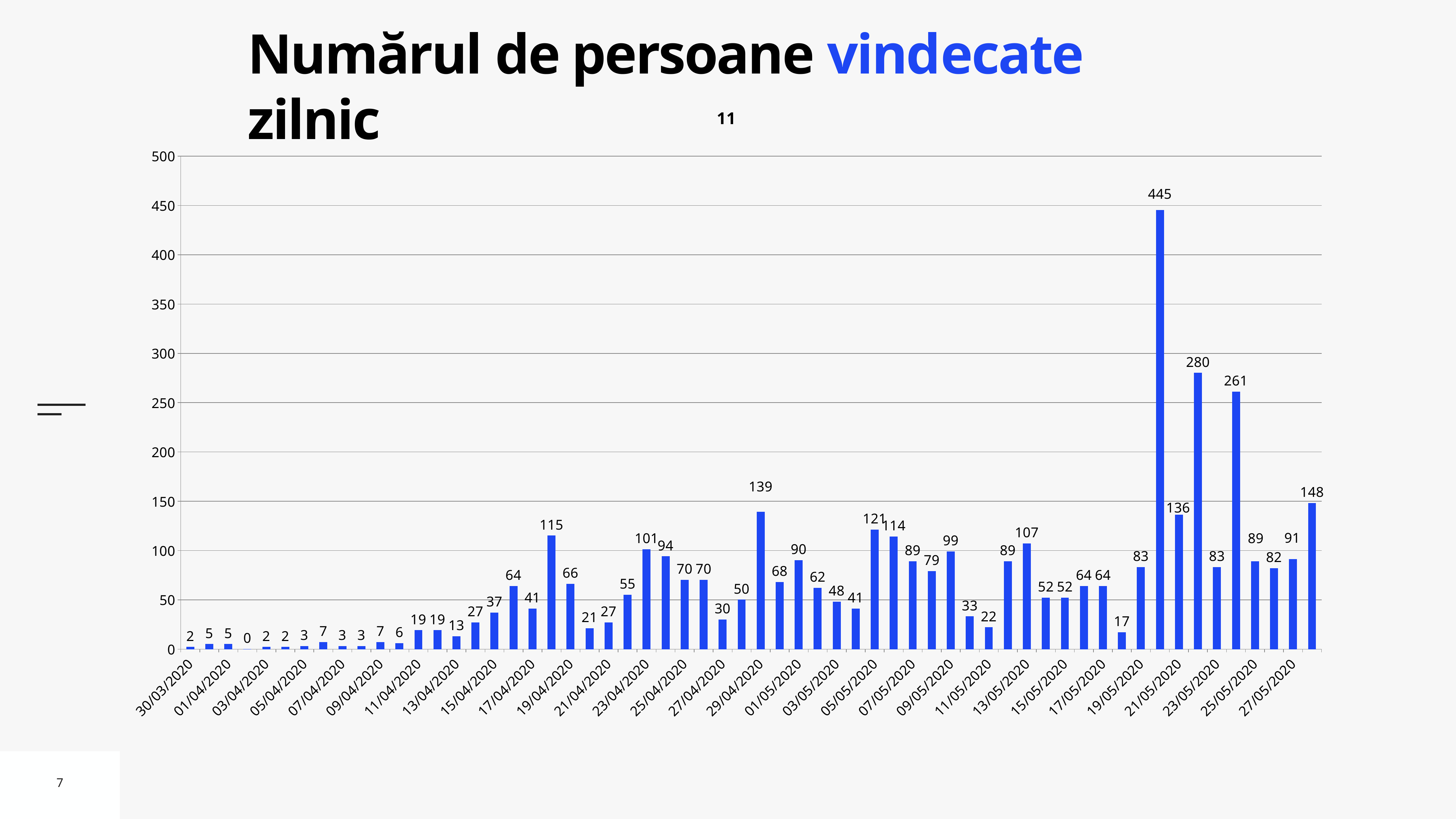
Which is larger, the value for 13/05/2020 or the value for 15/05/2020? 13/05/2020 What kind of chart is shown on the slide? bar chart What is the highest value shown in the chart? 445 What is the value for 11/04/2020? 19 What is the value for 23/04/2020? 101 What is the title of the slide? Numărul de persoane vindecate zilnic Which is larger, the value for 05/05/2020 or the value for 11/05/2020? 05/05/2020 What is the lowest value shown in the chart? 0 What is the value for 27/05/2020? 91 What is the difference between the values for 29/04/2020 and 01/05/2020? 49 What is the value for 29/04/2020? 139 What is the value for 21/05/2020? 136